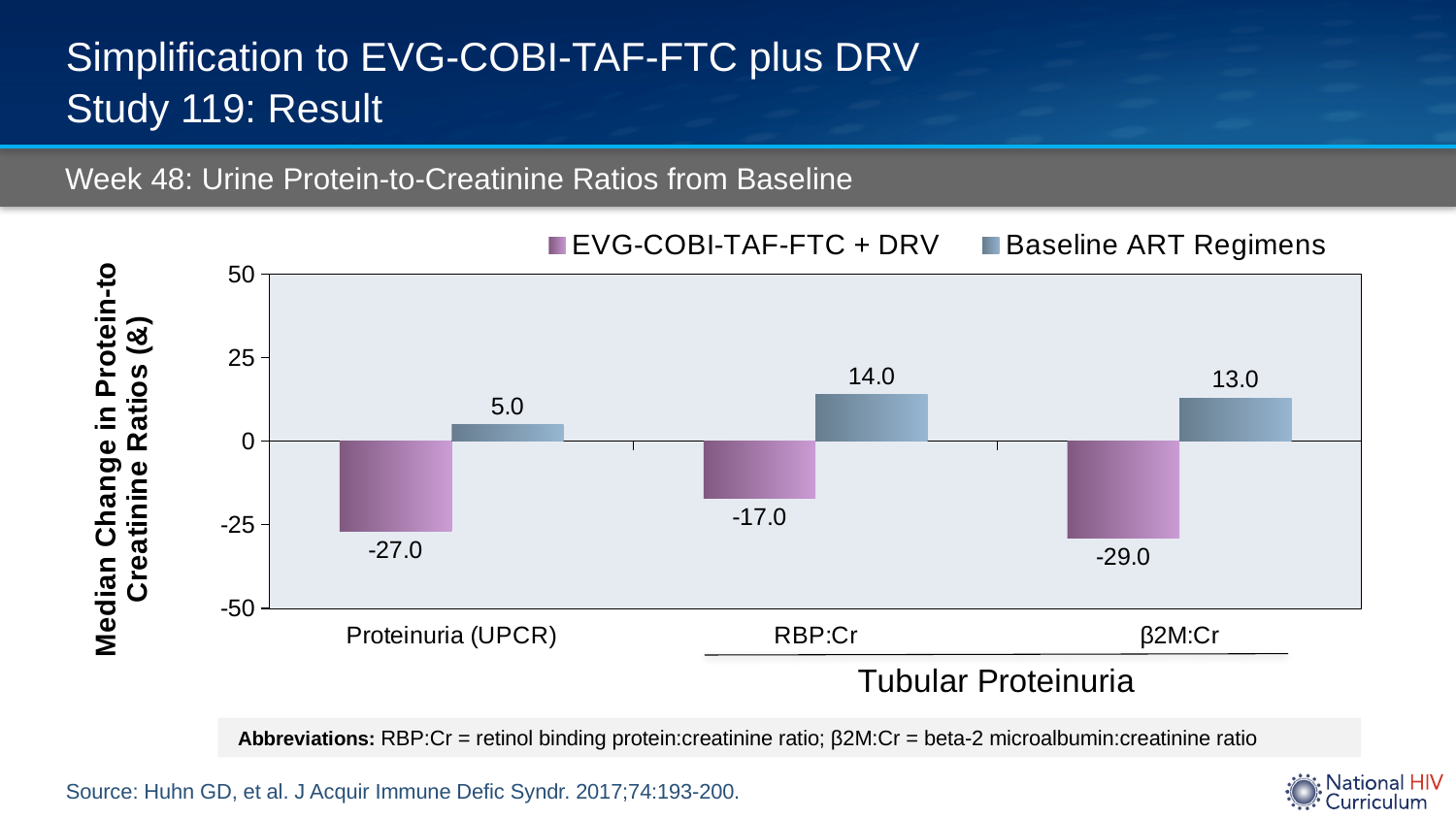
Which category has the lowest value in the EVG-COBI-TAF-FTC + DRV series? β2M:Cr For β2M:Cr, which group has the larger value: EVG-COBI-TAF-FTC + DRV or Baseline ART Regimens? Baseline ART Regimens What is the difference between the Baseline ART Regimens value and the EVG-COBI-TAF-FTC + DRV value for RBP:Cr? 31.0 Is the value for Proteinuria (UPCR) in the EVG-COBI-TAF-FTC + DRV group greater or less than -25? less What is the value for RBP:Cr in the Baseline ART Regimens group? 14.0 How many series does the legend list? 2 What is the value for Proteinuria (UPCR) in the Baseline ART Regimens group? 5.0 What kind of chart is shown on the slide? Bar chart What is the median change in protein-to-creatinine ratio for Proteinuria (UPCR) in the EVG-COBI-TAF-FTC + DRV group? -27.0 How many categories are shown on the x axis of the chart? 3 What is the value for β2M:Cr in the EVG-COBI-TAF-FTC + DRV group? -29.0 Which category has the highest value in the Baseline ART Regimens series? RBP:Cr